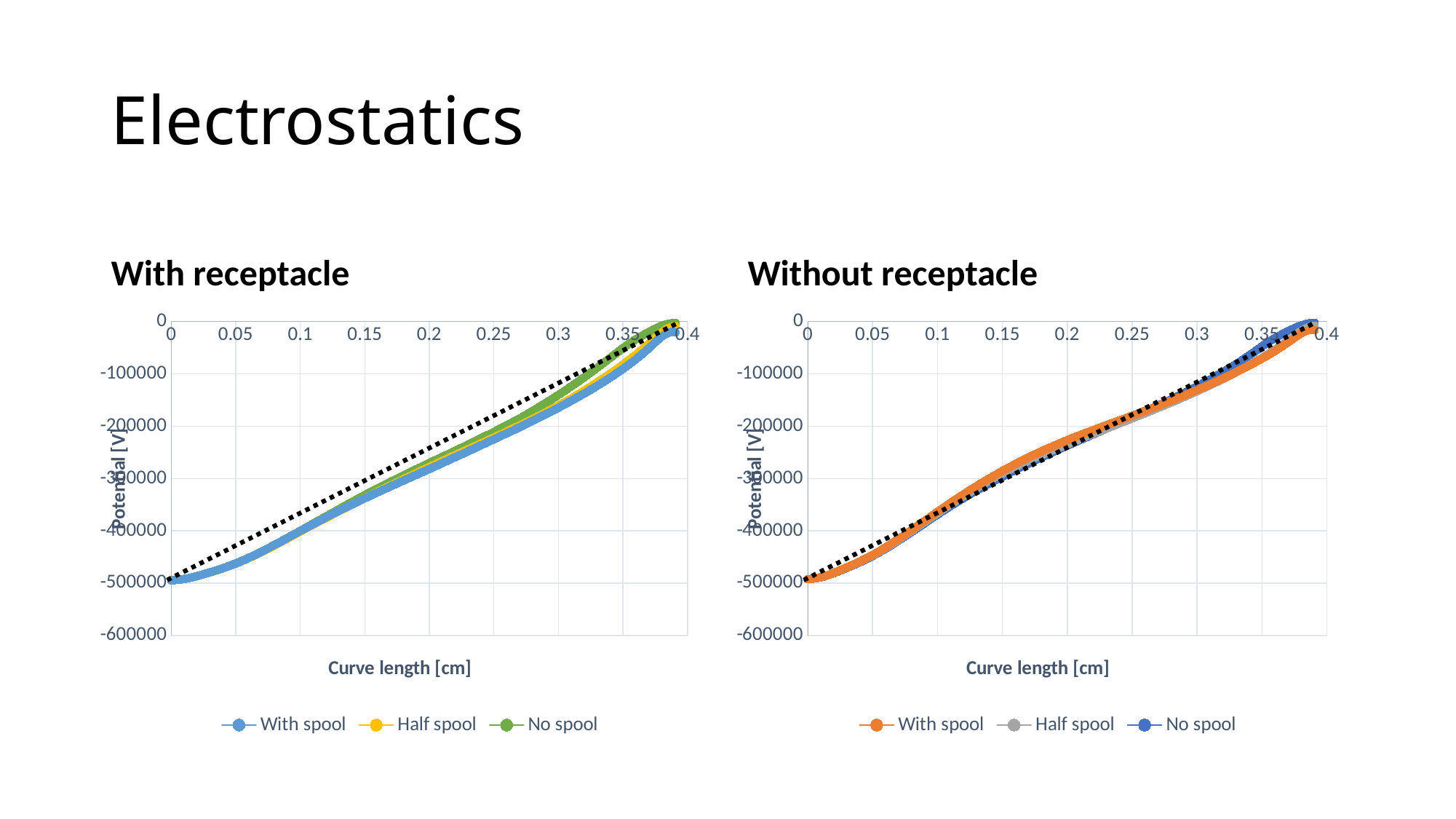
In the 'Without receptacle' chart, do the potential values rise or fall along the x axis? rise What type of chart is the 'With receptacle' chart? line chart Which series is shown in green in the 'With receptacle' chart? No spool How many series does the legend of the 'Without receptacle' chart list? 3 In the 'With receptacle' chart, do the potential values rise or fall as curve length increases from 0 to 0.4? rise In the 'Without receptacle' chart, is the 'With spool' value at curve length 0.1 greater or less than -300000? less In the 'Without receptacle' chart, is the 'With spool' value at curve length 0.3 greater or less than -200000? greater What is the x-axis title of the 'With receptacle' chart? Curve length [cm] In the 'With receptacle' chart, is the 'With spool' value at curve length 0.2 greater or less than -200000? less